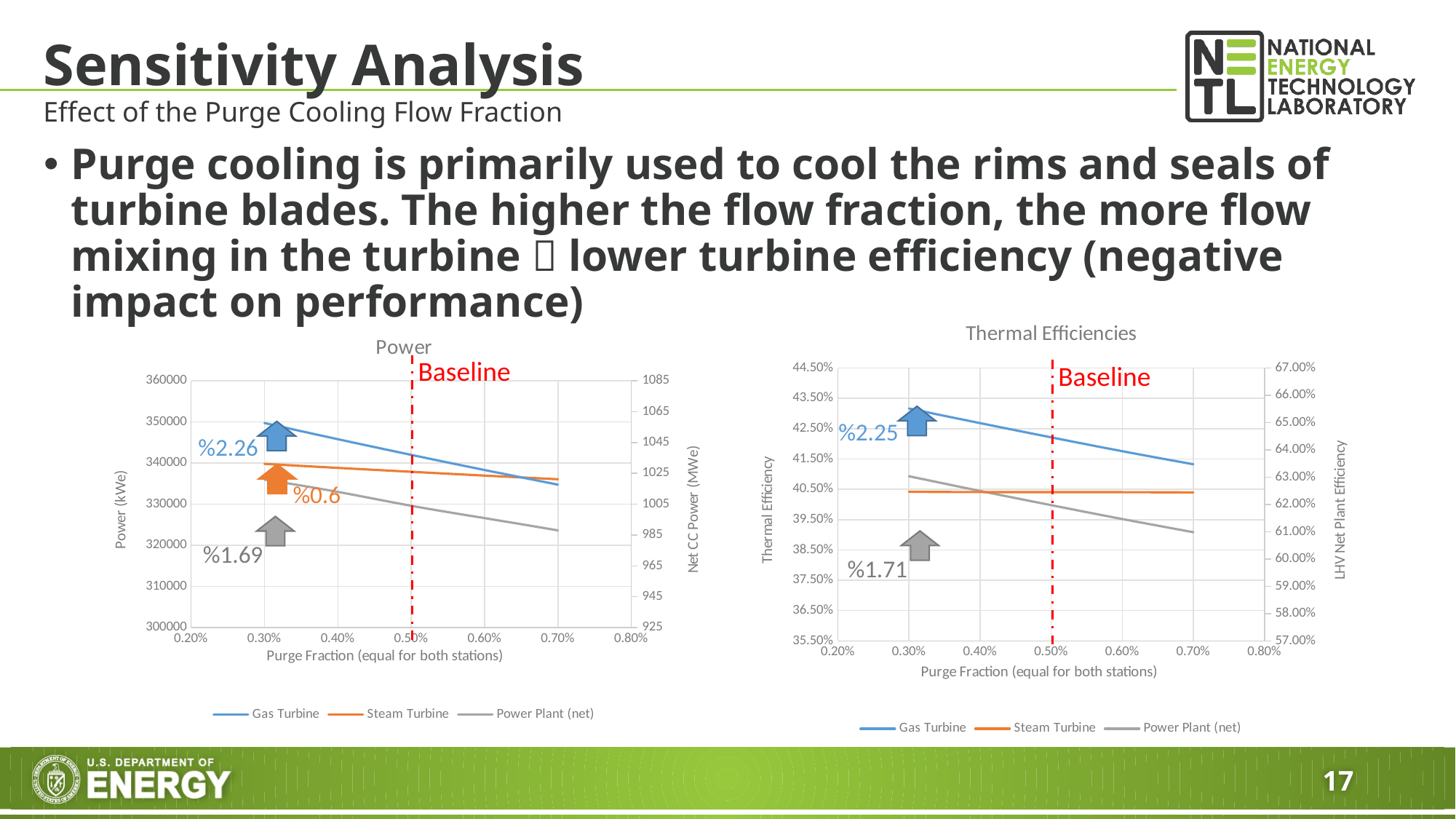
What kind of chart is the Power chart? line chart In the Thermal Efficiencies chart, is the Gas Turbine value at 0.30% purge fraction greater or less than 42.50%? greater At what purge fraction is the Baseline line drawn in the Thermal Efficiencies chart? 0.50% How many series does the legend of the Thermal Efficiencies chart list? 3 In the Power chart, is the Gas Turbine value at 0.30% purge fraction greater or less than 340000? greater In the Power chart, does the Gas Turbine line rise or fall as the purge fraction increases? fall What is the title of the chart on the right side of the slide? Thermal Efficiencies In the Thermal Efficiencies chart, which is higher at 0.50% purge fraction, Gas Turbine or Steam Turbine? Gas Turbine In the Thermal Efficiencies chart, is the Gas Turbine value at 0.70% purge fraction greater or less than 42.50%? less In the Power chart, which is higher at 0.30% purge fraction, Gas Turbine or Steam Turbine? Gas Turbine In the Thermal Efficiencies chart, does the Power Plant (net) line rise or fall as the purge fraction increases? fall